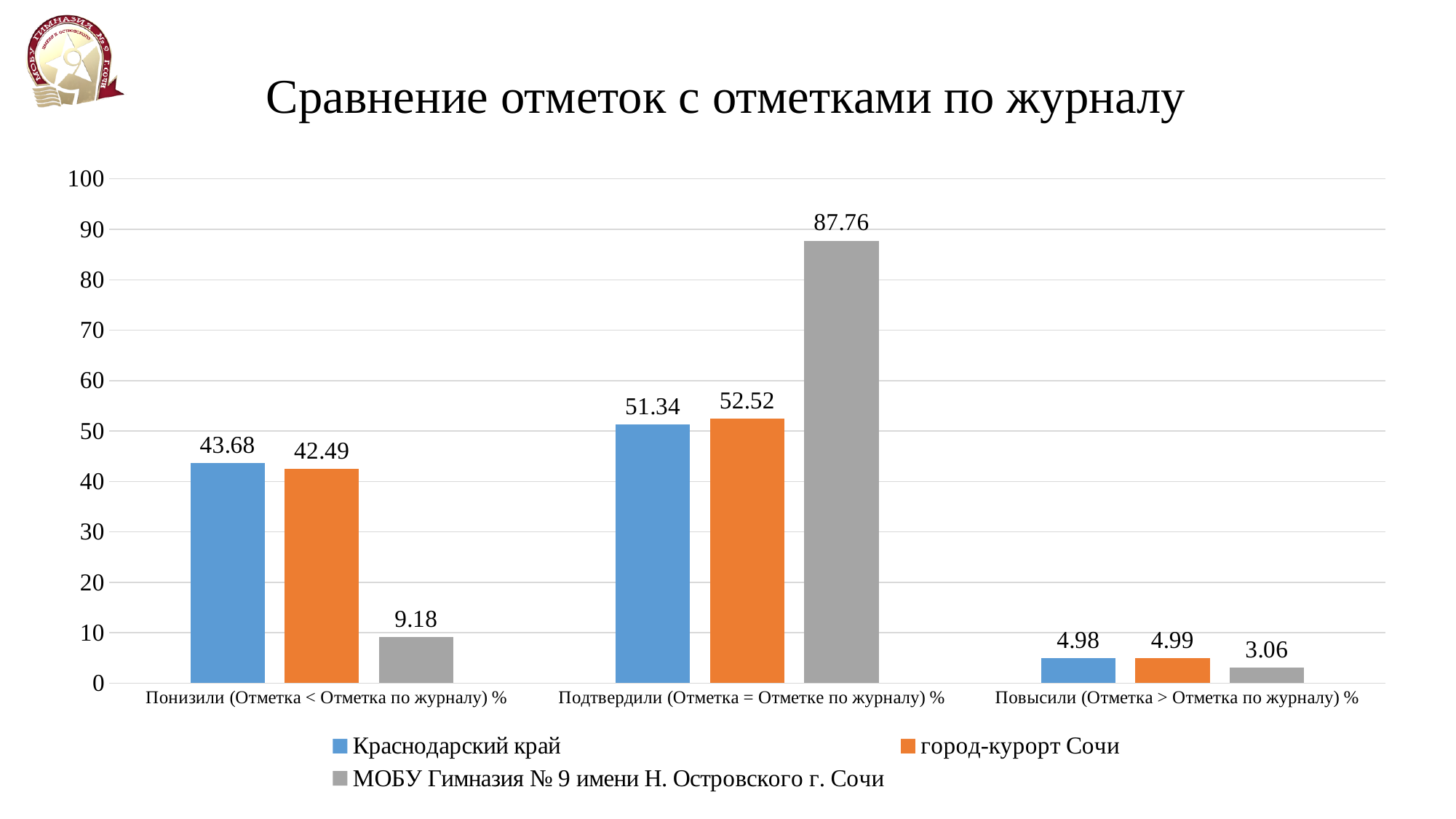
How many series does the legend list? 3 Which category has the lowest value for Краснодарский край? Повысили (Отметка > Отметка по журналу) % What type of chart is shown on the slide? bar chart What is the title of the chart? Сравнение отметок с отметками по журналу What is the value for Краснодарский край in the category Понизили (Отметка < Отметка по журналу) %? 43.68 What is the value for МОБУ Гимназия № 9 имени Н. Островского г. Сочи in the category Подтвердили (Отметка = Отметке по журналу) %? 87.76 Which series is shown in grey? МОБУ Гимназия № 9 имени Н. Островского г. Сочи What is the difference between the values for МОБУ Гимназия № 9 имени Н. Островского г. Сочи and город-курорт Сочи in the category Подтвердили (Отметка = Отметке по журналу) %? 35.24 How many categories are shown on the x axis? 3 In the category Понизили (Отметка < Отметка по журналу) %, which is larger: Краснодарский край or город-курорт Сочи? Краснодарский край Which category has the highest value for МОБУ Гимназия № 9 имени Н. Островского г. Сочи? Подтвердили (Отметка = Отметке по журналу) % What is the value for город-курорт Сочи in the category Повысили (Отметка > Отметка по журналу) %? 4.99